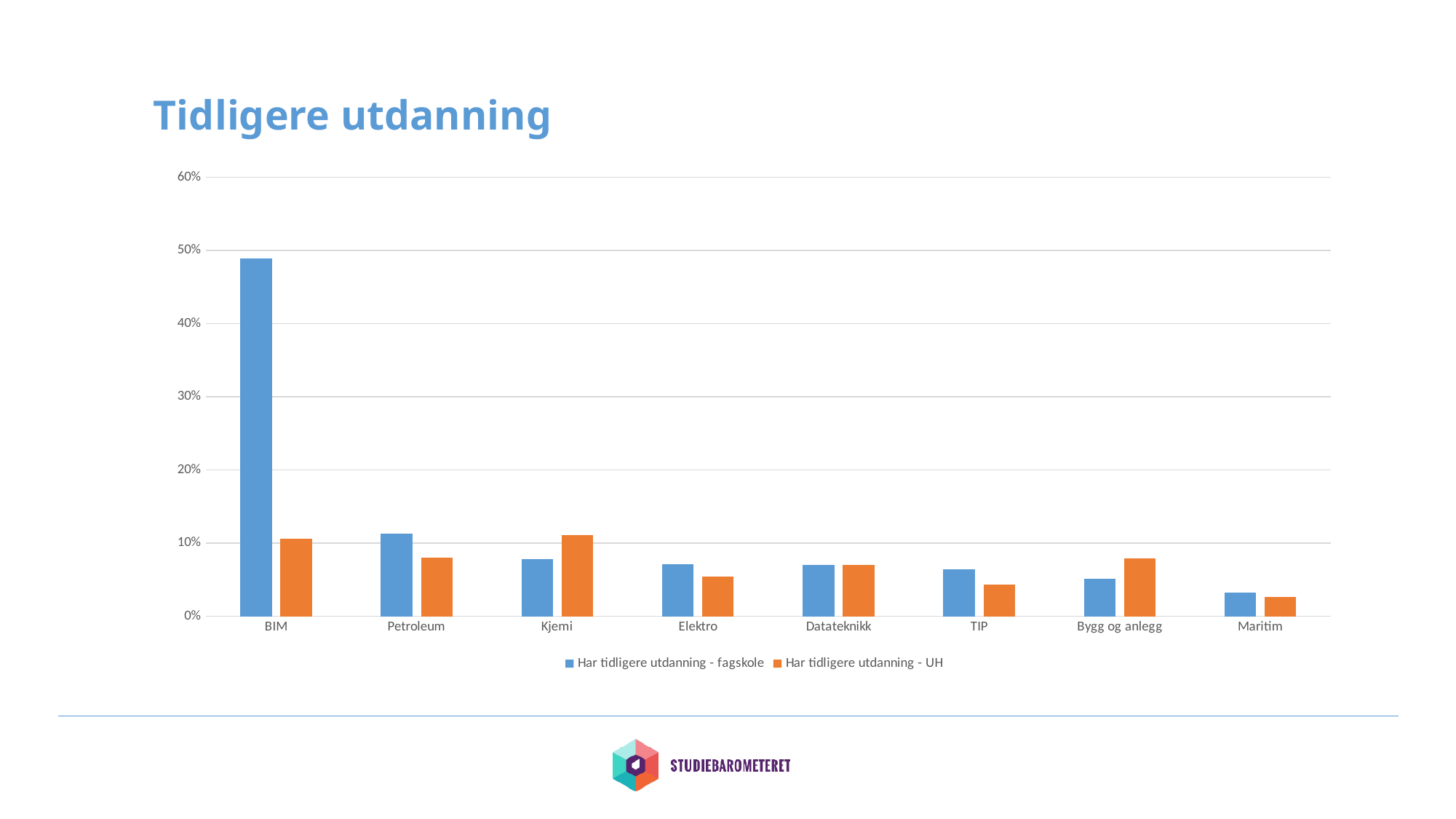
Which category has the lowest value for 'Har tidligere utdanning - fagskole'? Maritim Is the value for Petroleum in the 'Har tidligere utdanning - fagskole' series greater or less than 10%? greater What kind of chart is shown on the slide? bar chart For Bygg og anlegg, which series has the larger value: 'Har tidligere utdanning - fagskole' or 'Har tidligere utdanning - UH'? Har tidligere utdanning - UH What is the title of the chart? Tidligere utdanning Is the value for BIM in the 'Har tidligere utdanning - fagskole' series greater or less than 40%? greater How many categories are shown on the x axis of the chart? 8 Which category has the highest value for 'Har tidligere utdanning - fagskole'? BIM How many series does the legend list? 2 For Kjemi, which series has the larger value: 'Har tidligere utdanning - fagskole' or 'Har tidligere utdanning - UH'? Har tidligere utdanning - UH Is the value for Elektro in the 'Har tidligere utdanning - UH' series greater or less than 10%? less Which category has the lowest value for 'Har tidligere utdanning - UH'? Maritim